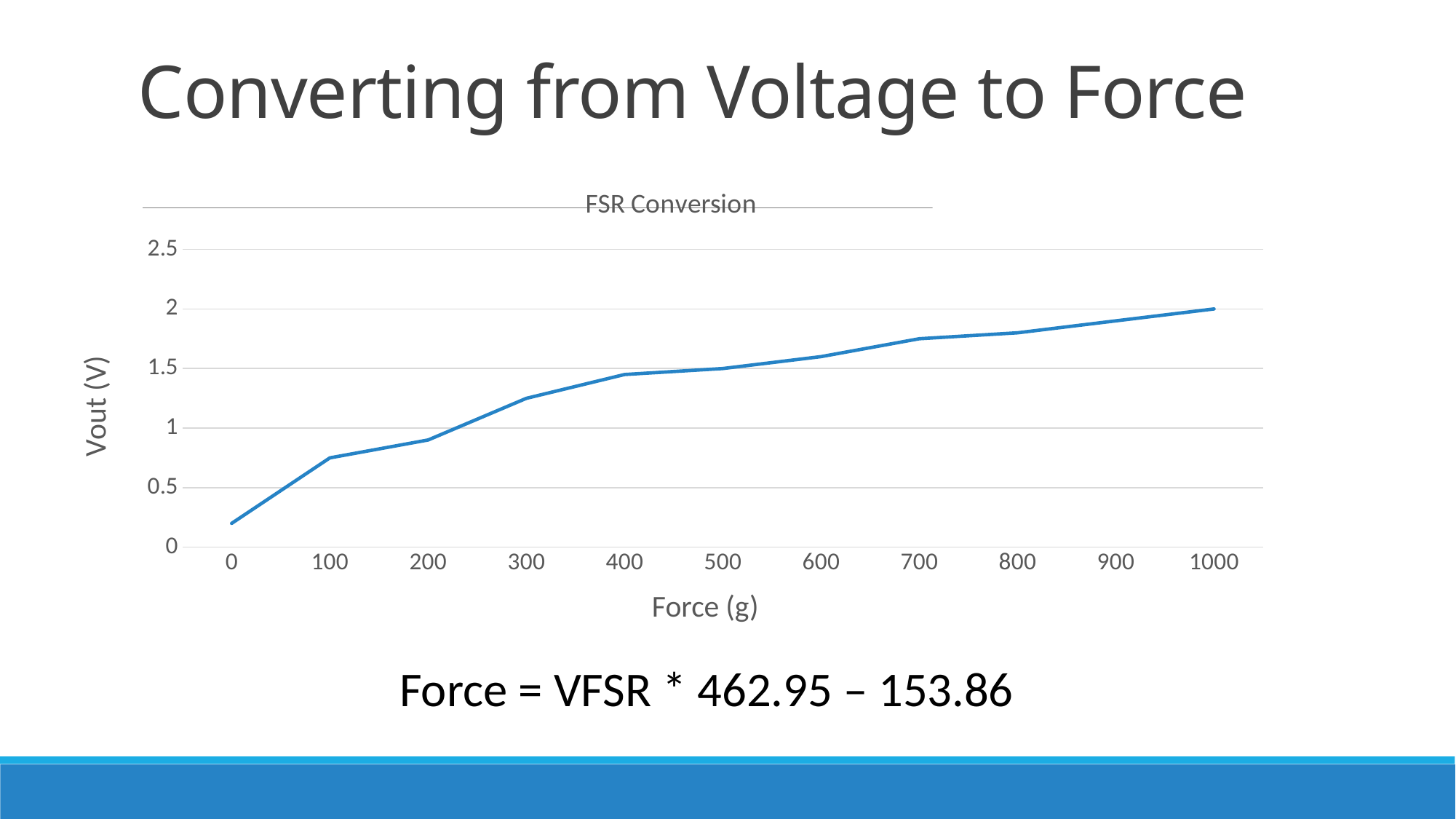
What is the title of the chart? FSR Conversion Is the Vout value at a Force of 100 g greater or less than 0.5? greater Is the Vout value at a Force of 0 g greater or less than 0.5? less Which has a larger Vout value: a Force of 200 g or a Force of 600 g? 600 g How many data points are plotted on the line? 11 Is the Vout value at a Force of 300 g greater or less than 1? greater At which Force value is Vout highest? 1000 What is the label of the y axis of the chart? Vout (V) At which Force value is Vout lowest? 0 What kind of chart is shown on the slide? line chart Do the Vout values rise or fall as Force increases along the x axis? rise